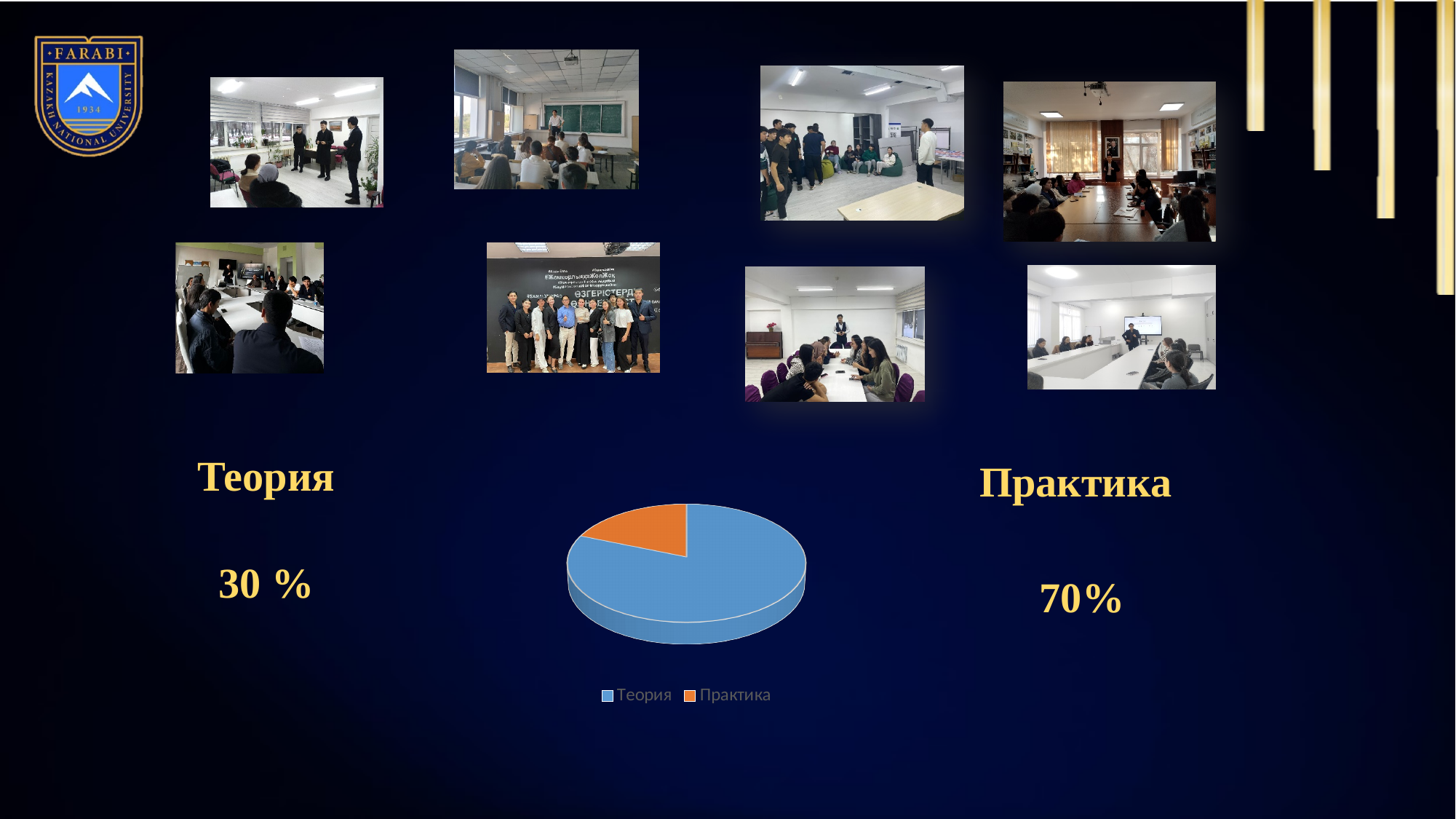
Which slice of the pie chart is the largest? Теория In the pie chart, which slice is larger, Теория or Практика? Теория What kind of chart is shown on the slide? pie chart How many entries does the pie chart's legend list? 2 How many slices does the pie chart have? 2 Which slice of the pie chart is the smallest? Практика What are the two entries listed in the pie chart's legend? Теория, Практика What colour is the Практика slice in the pie chart? orange